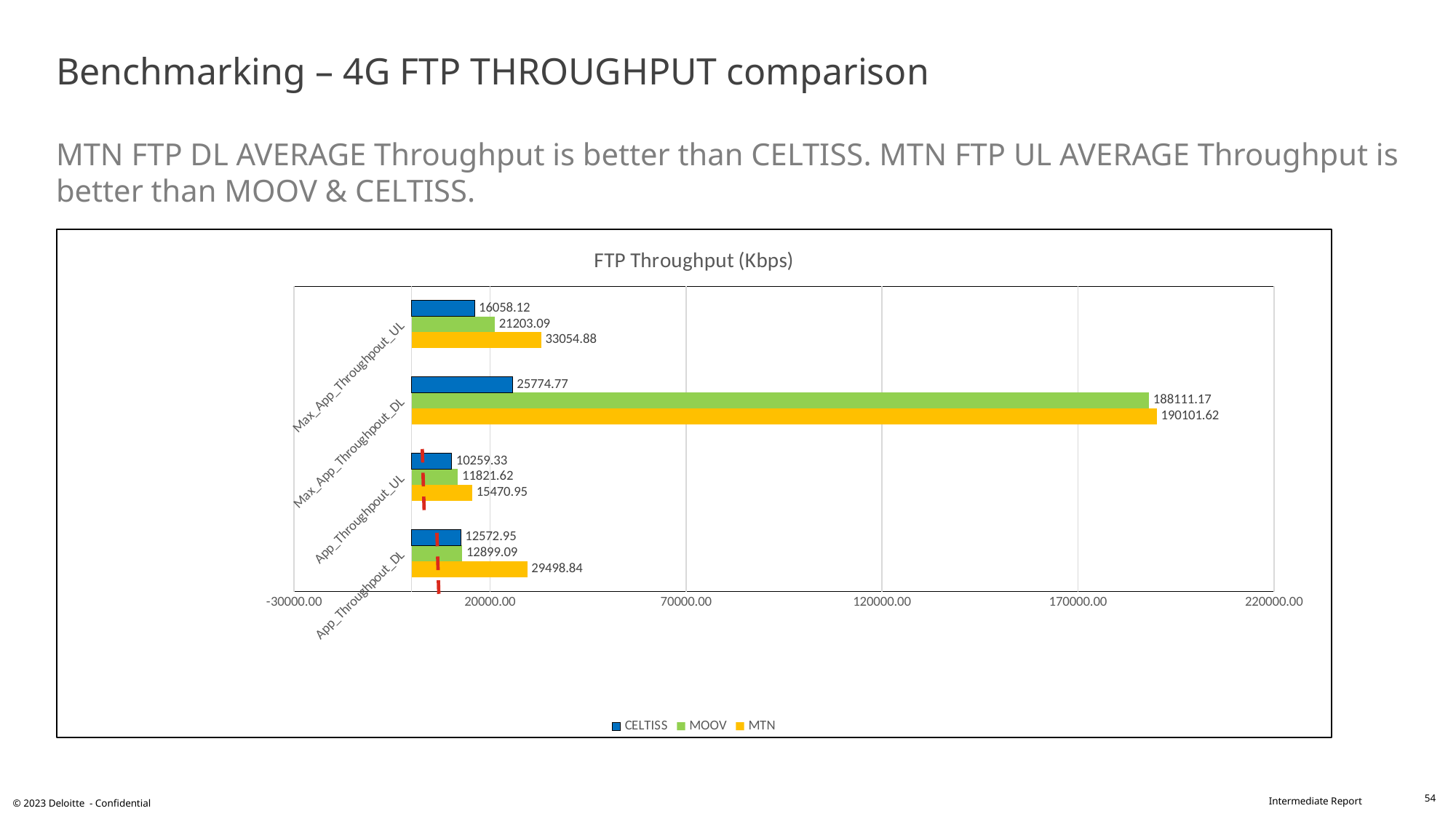
What is the MTN value for App_Throughput_DL? 29498.84 What is the MTN value for Max_App_Throughput_DL? 190101.62 How many series does the legend list? 3 What is the difference between the MTN and MOOV values for Max_App_Throughput_DL? 1990.45 What is the CELTISS value for App_Throughput_UL? 10259.33 What type of chart is shown on the slide? Bar chart Which operator has the highest value for App_Throughput_UL? MTN How many categories are shown on the vertical axis of the chart? 4 What is the MOOV value for Max_App_Throughput_UL? 21203.09 What is the difference between the MTN and CELTISS values for App_Throughput_DL? 16925.89 Which is larger for App_Throughput_DL: the MOOV value or the MTN value? MTN Which operator has the lowest value for Max_App_Throughput_DL? CELTISS